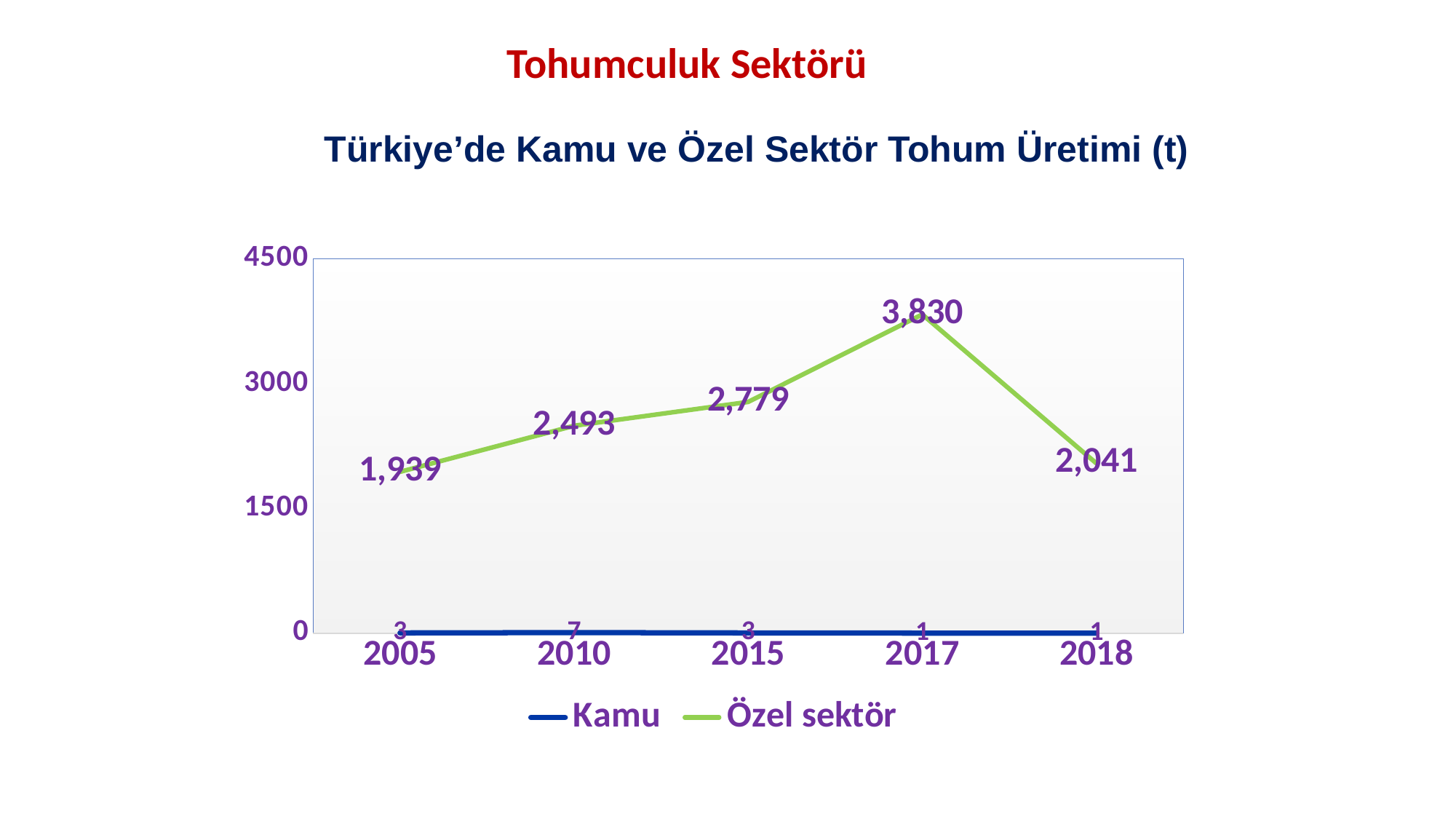
What type of chart is shown on the slide? Line chart What is the Özel sektör value for 2018? 2,041 What is the difference between the Özel sektör values for 2017 and 2018? 1,789 What is the Özel sektör value for 2010? 2,493 What is the Özel sektör value for 2017? 3,830 In which year is the Özel sektör value highest? 2017 What is the title of the chart? Türkiye'de Kamu ve Özel Sektör Tohum Üretimi (t) How many series does the legend list? 2 How many years are shown on the x axis? 5 In which year is the Özel sektör value lowest? 2005 Which is larger, the Özel sektör value for 2015 or for 2010? 2015 What is the Özel sektör value for 2005? 1,939